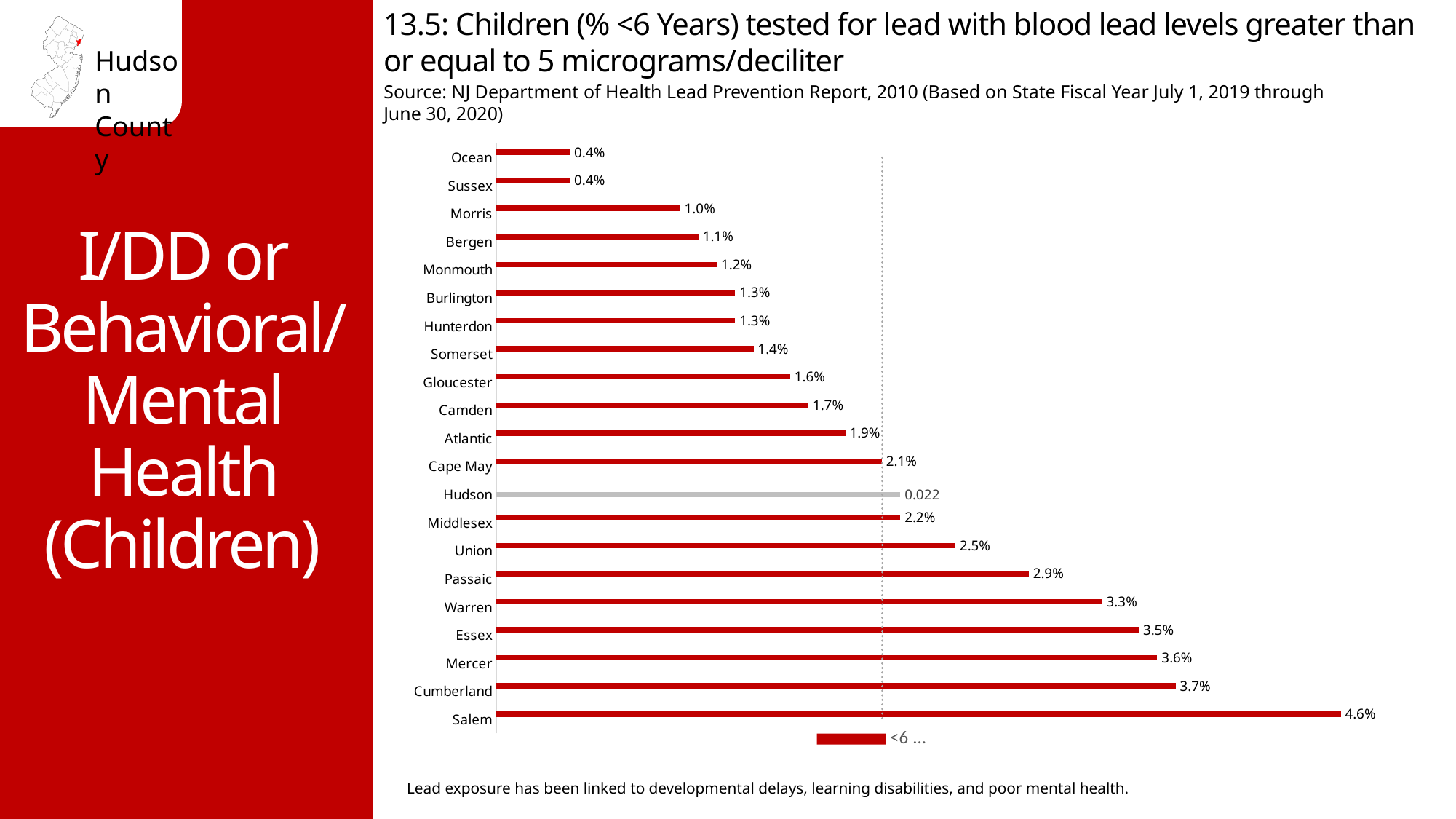
What label is printed next to the Hudson bar? 0.022 What kind of chart is shown on the slide? bar chart How many counties are plotted in the chart? 21 What is the value shown for Passaic? 2.9% What is the difference between the values for Salem and Cumberland? 0.9% Do the values increase or decrease going from the top of the chart (Ocean) to the bottom (Salem)? increase Which has a larger value, Mercer or Warren? Mercer What is the value shown for Gloucester? 1.6% Which has a larger value, Camden or Atlantic? Atlantic What is the value shown for Salem? 4.6% Which county has the highest value in the chart? Salem What is the difference between the values for Essex and Union? 1.0%